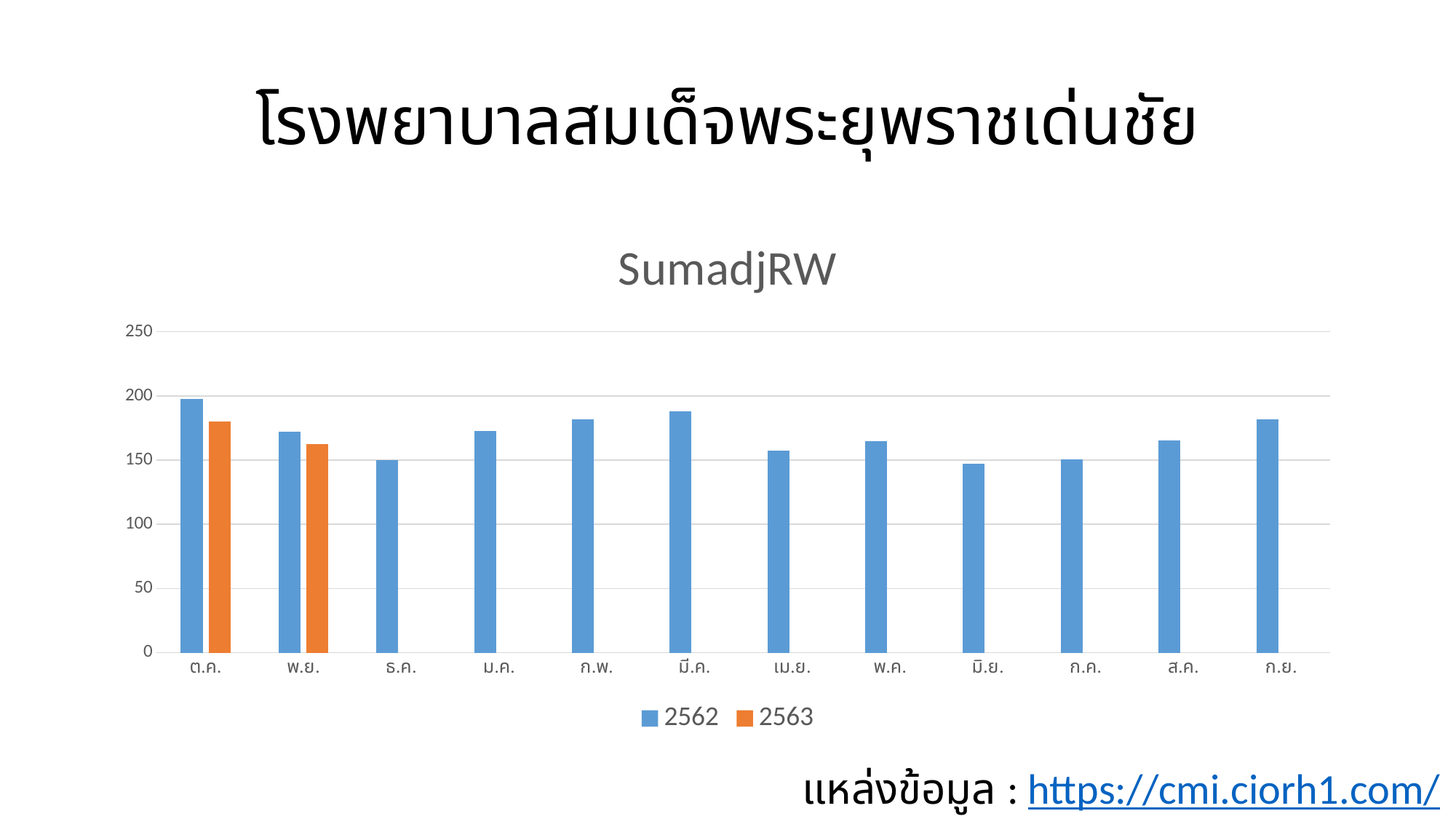
Which series is shown in orange? 2563 How many month categories are shown on the x axis? 12 In ต.ค., which series has the larger value, 2562 or 2563? 2562 What kind of chart is shown on the slide? bar chart Which month has the highest value for the 2562 series? ต.ค. For how many months does the 2563 series have a bar? 2 Is the 2562 value for ต.ค. greater or less than 150? greater For the 2562 series, which is larger, มี.ค. or เม.ย.? มี.ค. What is the title of the chart? SumadjRW In พ.ย., which series has the larger value, 2562 or 2563? 2562 How many series does the legend list? 2 Is the 2562 value for ธ.ค. greater or less than 200? less